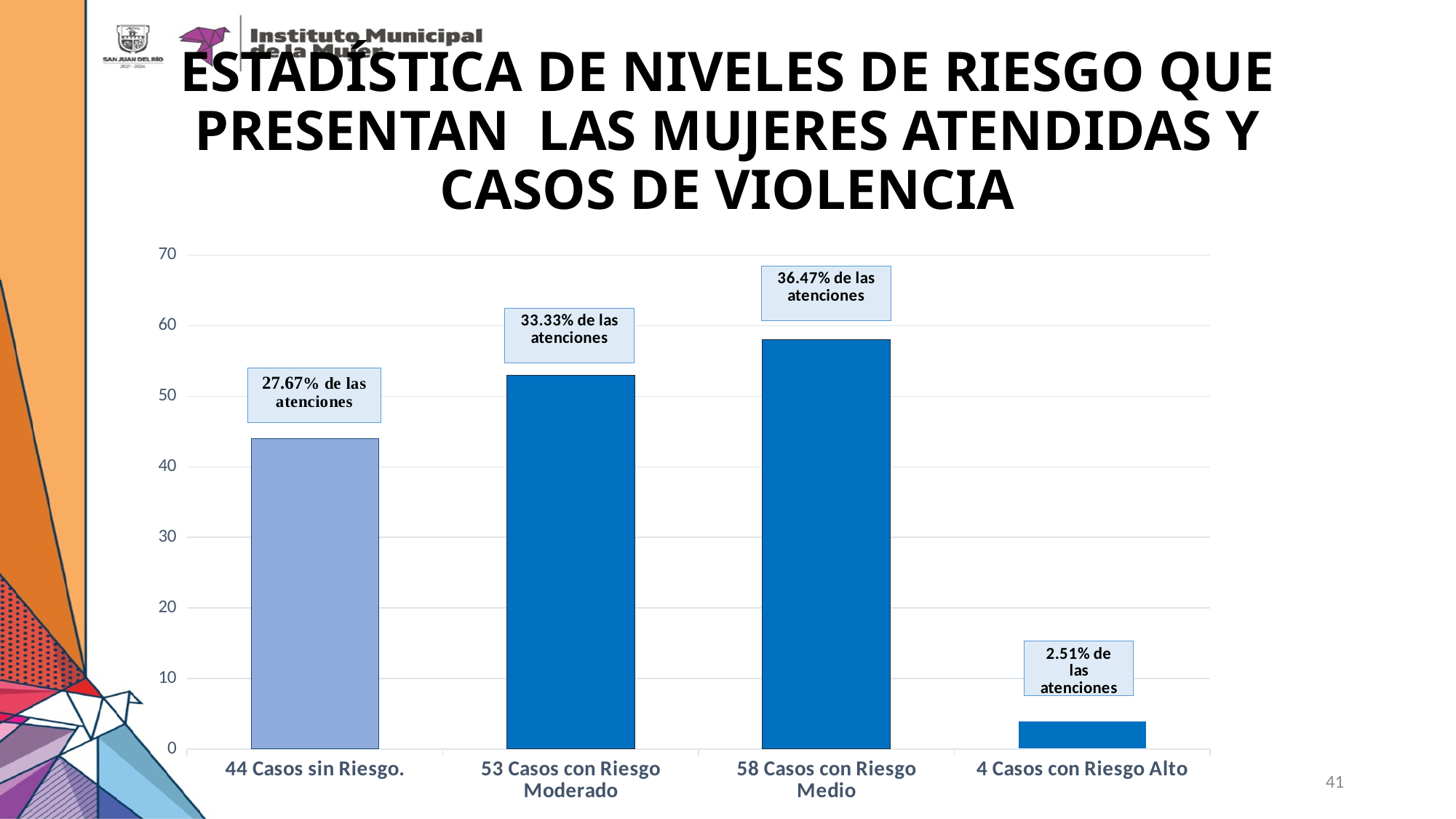
Is the value for 'Casos con Riesgo Alto' greater or less than 10? less How many categories (bars) does the chart show? 4 Which bar is shown in a lighter blue colour than the others? 44 Casos sin Riesgo. Which category has the highest bar? 58 Casos con Riesgo Medio What kind of chart is shown on the slide? bar chart How many cases are reported for Riesgo Medio according to the category label? 58 What is the difference in number of cases between Riesgo Medio and Riesgo Moderado? 5 Which category has the lowest bar? 4 Casos con Riesgo Alto What percentage of the atenciones corresponds to the 'Casos con Riesgo Moderado' bar? 33.33% What percentage of the atenciones corresponds to the 'Casos sin Riesgo' bar? 27.67% What percentage of the atenciones corresponds to the 'Casos con Riesgo Alto' bar? 2.51% Which is larger: the number of cases sin Riesgo or the number of cases con Riesgo Moderado? 53 Casos con Riesgo Moderado